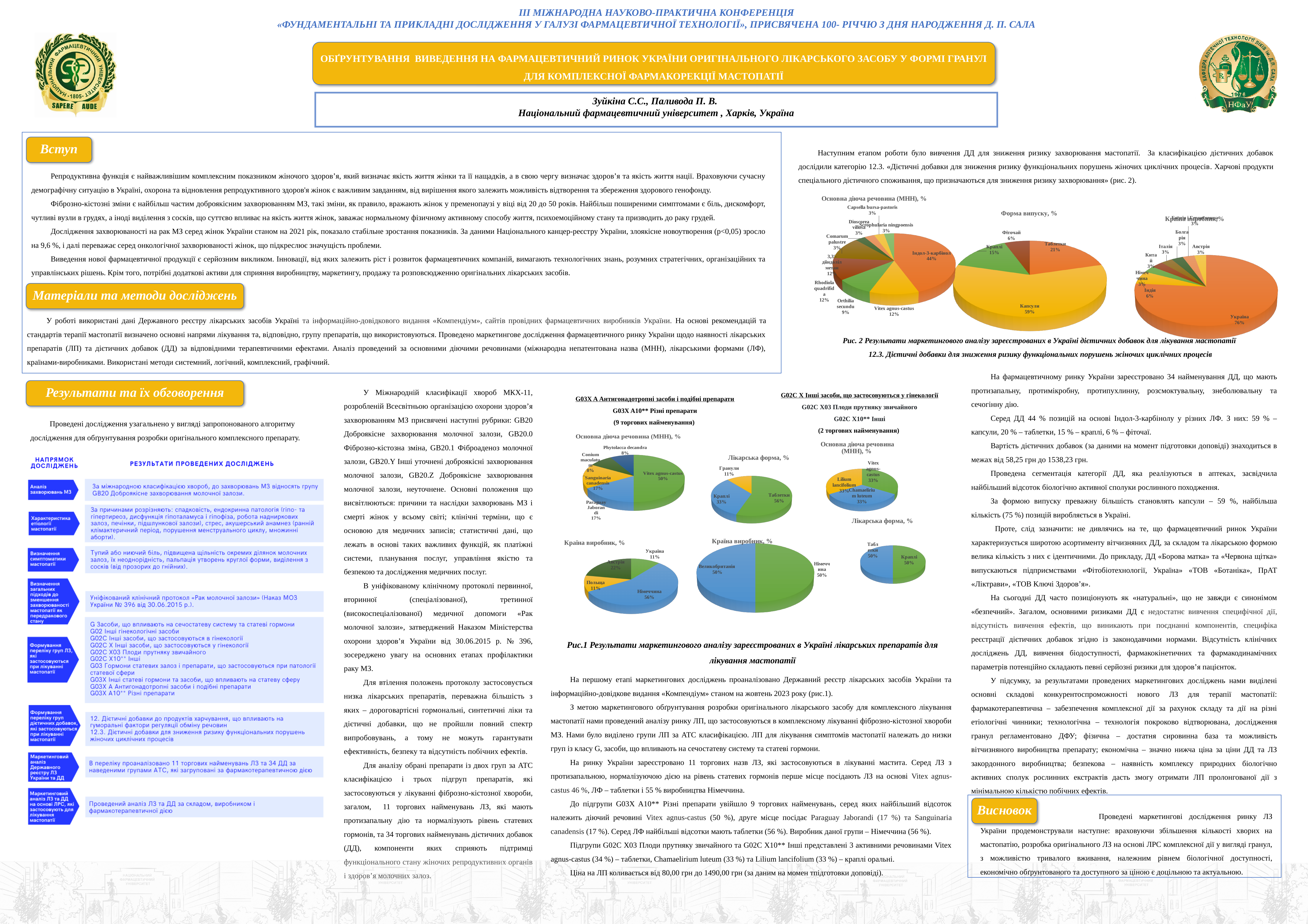
In the 'Форма випуску, %' pie chart of Рис. 2, which is larger: Таблетки or Краплі? Таблетки In Рис. 1, in the 'Країна виробник, %' pie chart for G03X A10** Різні препарати, which country has the largest share? Німеччина In Рис. 1, how many categories are shown in the 'Лікарська форма, %' pie chart for G03X A10** Різні препарати? 3 In the 'Форма випуску, %' pie chart of Рис. 2, which category has the smallest share? Фіточай In the 'Країна виробник, %' pie chart of Рис. 2, what share does Україна have? 76% What type of chart is used for 'Форма випуску, %' in Рис. 2? Pie chart In the 'Основна діюча речовина (МНН), %' pie chart of Рис. 2, which active substance has the largest share? Індол-3-карбінол In Рис. 1, in the 'Основна діюча речовина (МНН), %' pie chart for G03X A10** Різні препарати, what share does Vitex agnus-castus have? 50% In the 'Форма випуску, %' pie chart of Рис. 2, what share do Капсули have? 59% In the 'Основна діюча речовина (МНН), %' pie chart of Рис. 2, what is the difference between the shares of Індол-3-карбінол and Vitex agnus-castus? 32% In Рис. 1, in the 'Лікарська форма, %' pie chart for G03X A10** Різні препарати, what share do Таблетки have? 56% In Рис. 1, in the 'Країна виробник, %' pie chart for G02C X10** Інші, what share does Великобританія have? 50%